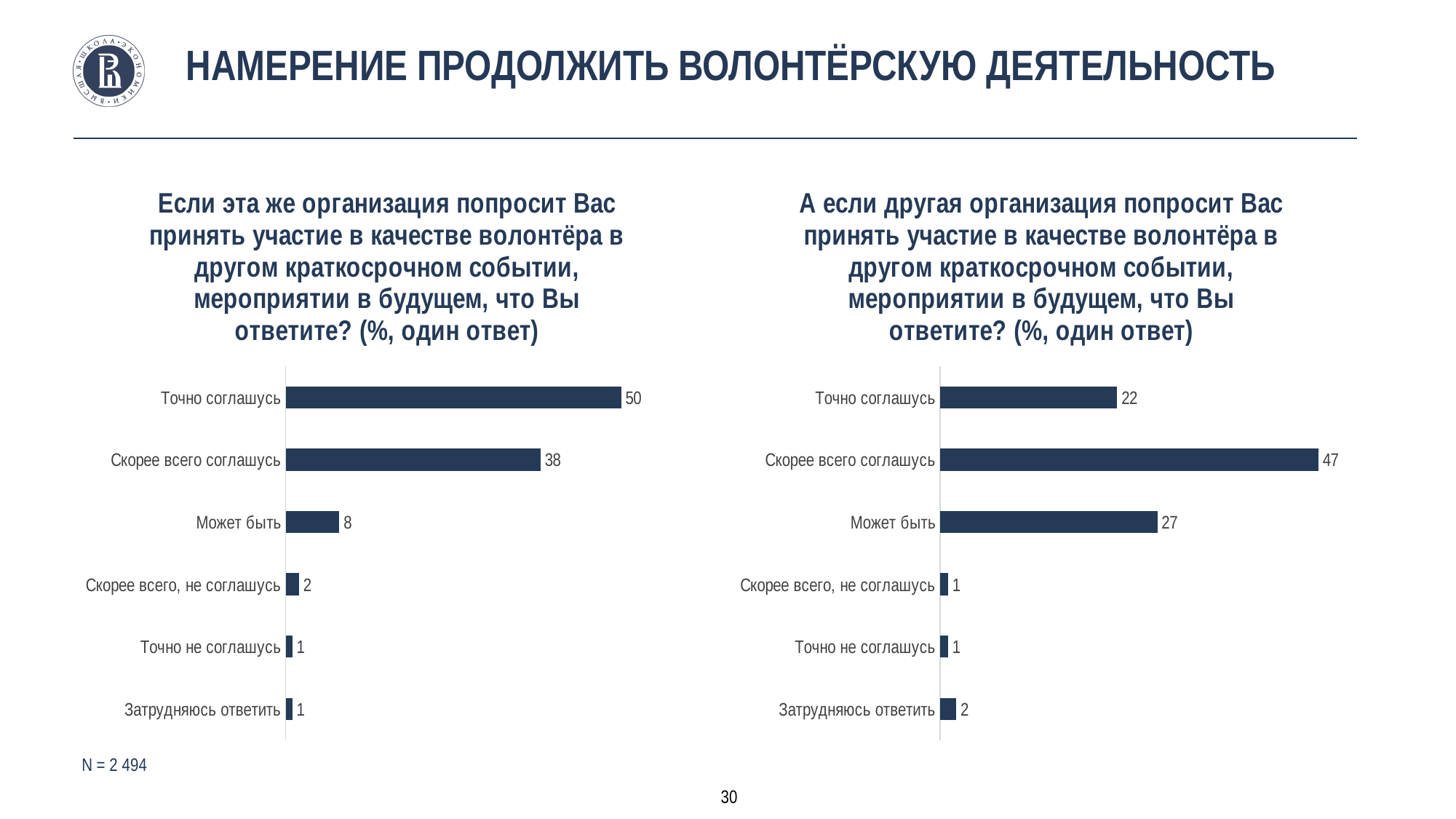
In the right chart (other organisation), what is the value for "Может быть"? 27 In the right chart (other organisation), which category has the highest value? Скорее всего соглашусь In the right chart (other organisation), what is the value for "Скорее всего соглашусь"? 47 What sample size (N) is stated on the slide? N = 2 494 In the left chart (same organisation), what is the value for "Точно соглашусь"? 50 In the left chart (same organisation), what is the value for "Скорее всего, не соглашусь"? 2 What kind of chart is the right chart (other organisation)? Bar chart How many categories does the left chart (same organisation) show? 6 In the left chart (same organisation), what is the difference between "Точно соглашусь" and "Скорее всего соглашусь"? 12 In the left chart (same organisation), which category has the highest value? Точно соглашусь Which is larger: "Может быть" in the left chart or "Может быть" in the right chart? Right chart (27) In the right chart (other organisation), what is the difference between "Скорее всего соглашусь" and "Точно соглашусь"? 25